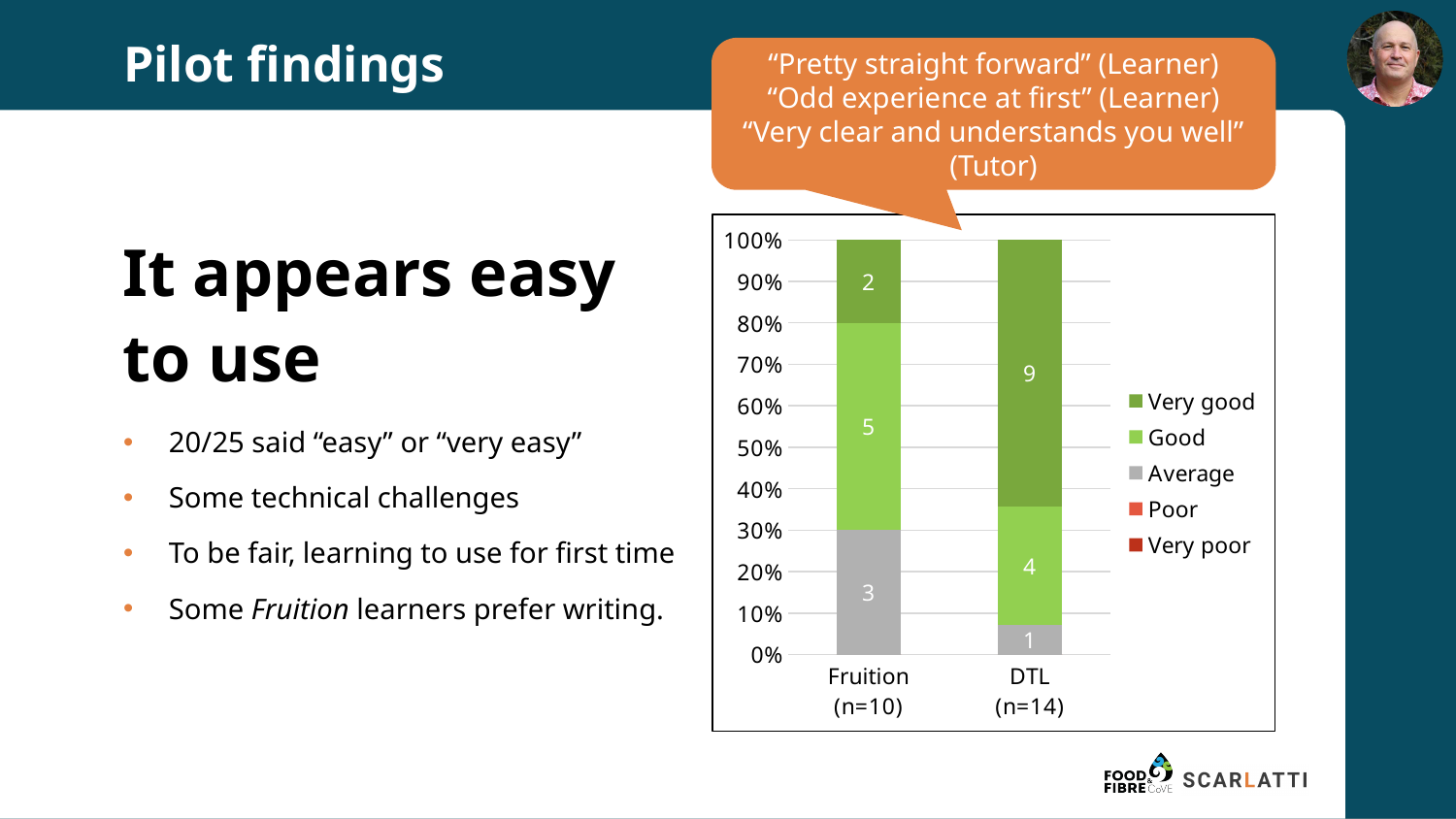
What is the "Average" count for Fruition? 3 What is the total number of responses in the Fruition bar? 10 What is the "Average" count for DTL? 1 Which group has more "Very good" ratings, Fruition or DTL? DTL How many Fruition respondents rated it "Good"? 5 How many series does the legend list? 5 How many categories (bars) are shown on the x axis? 2 In the DTL bar, is the boundary between the "Good" and "Very good" segments above or below 40% on the axis? below What is the total number of responses in the DTL bar? 14 What is the difference between the "Very good" counts for DTL and Fruition? 7 What kind of chart is shown on the slide? Stacked bar chart How many DTL respondents rated it "Very good"? 9